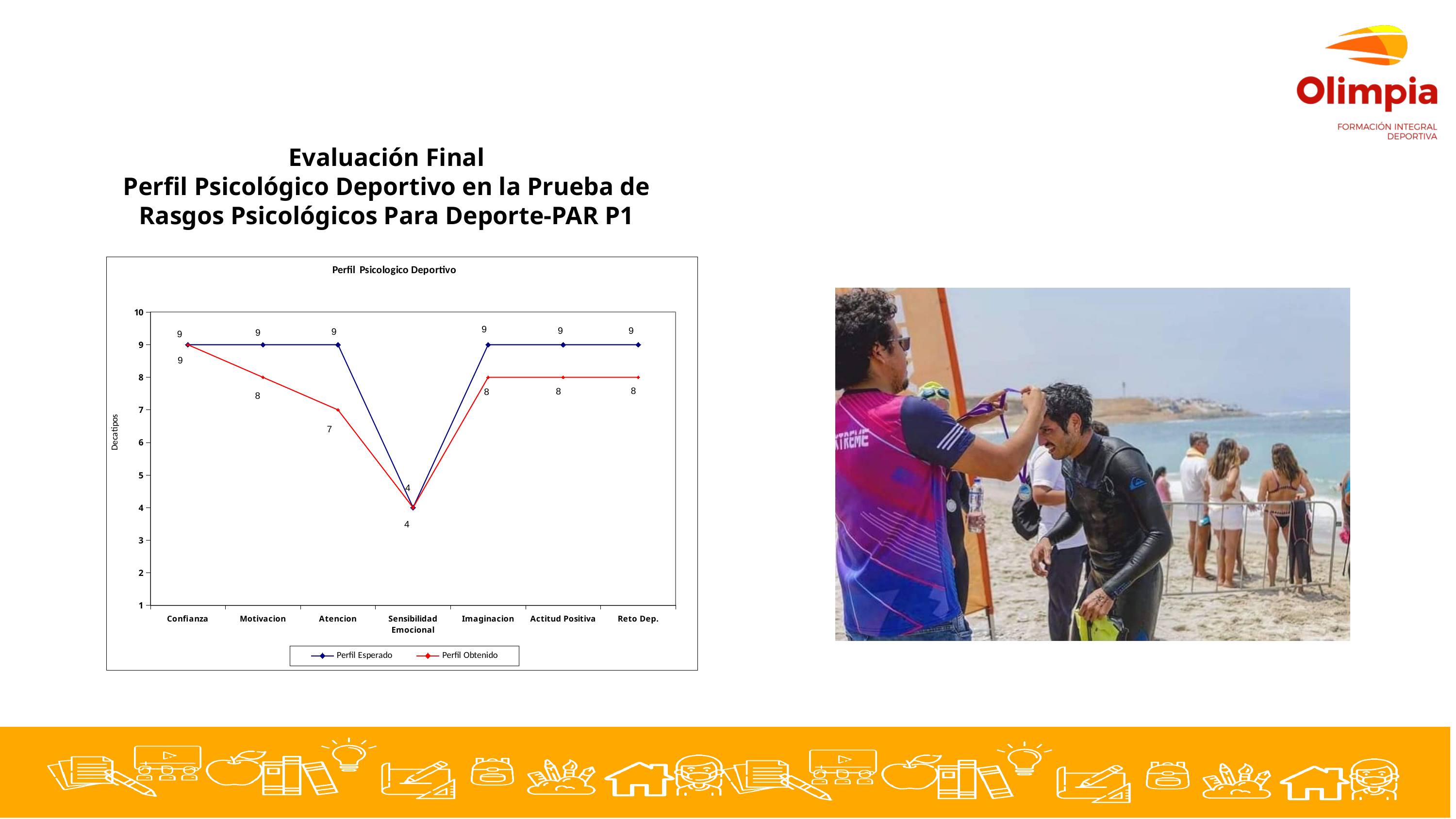
What is the Perfil Esperado value for Sensibilidad Emocional? 4 What is the title of the chart? Perfil Psicologico Deportivo Which category has the lowest Perfil Obtenido value? Sensibilidad Emocional What is the Perfil Obtenido value for Atencion? 7 What is the difference between the Perfil Esperado and Perfil Obtenido values for Atencion? 2 Which is larger for Imaginacion, the Perfil Esperado value or the Perfil Obtenido value? Perfil Esperado What is the label of the y axis of the chart? Decatipos Does the Perfil Obtenido line rise or fall from Confianza to Atencion? Fall How many series does the chart legend list? 2 What is the Perfil Obtenido value for Motivacion? 8 What type of chart is shown on the slide? Line chart How many categories are shown on the x axis of the chart? 7